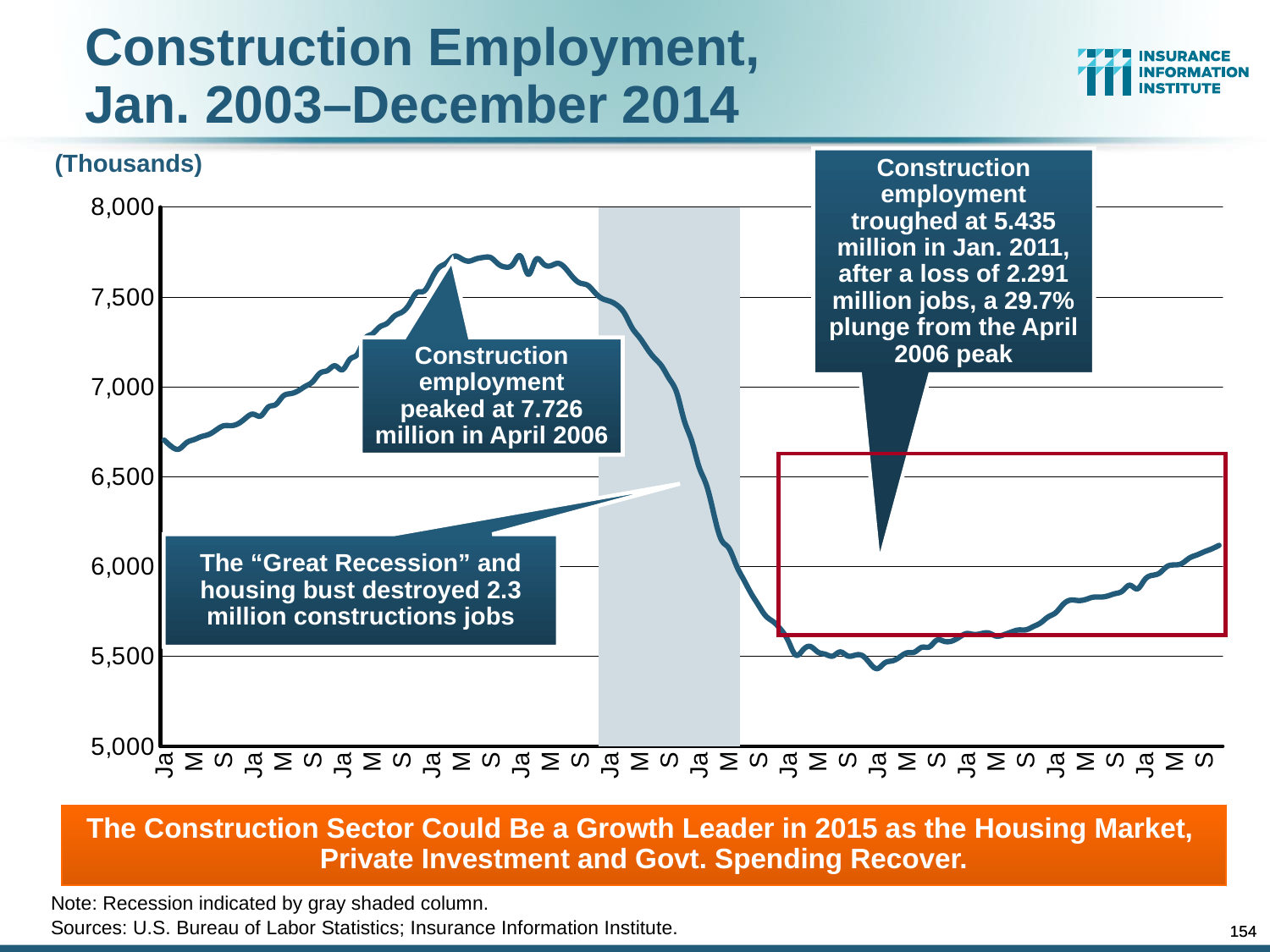
According to the annotation, at what level did construction employment trough in Jan. 2011? 5.435 million According to the annotation, at what level did construction employment peak in April 2006? 7.726 million Which is higher: construction employment in April 2006 or in January 2011? April 2006 In what units is the vertical axis expressed? Thousands Does construction employment rise or fall between the April 2006 peak and January 2011? Fall Is the construction employment value at the end of the series (late 2014) greater or less than 6,500? less What percentage plunge from the April 2006 peak does the annotation cite for the Jan. 2011 trough? 29.7% Is the construction employment value at the start of the series (Jan. 2003) greater or less than 6,500? greater How many jobs were lost between the April 2006 peak and the Jan. 2011 trough, according to the annotation? 2.291 million Does construction employment rise or fall from January 2011 to the end of 2014? Rise What is the highest value shown on the vertical axis? 8,000 What kind of chart is shown on the slide? Line chart